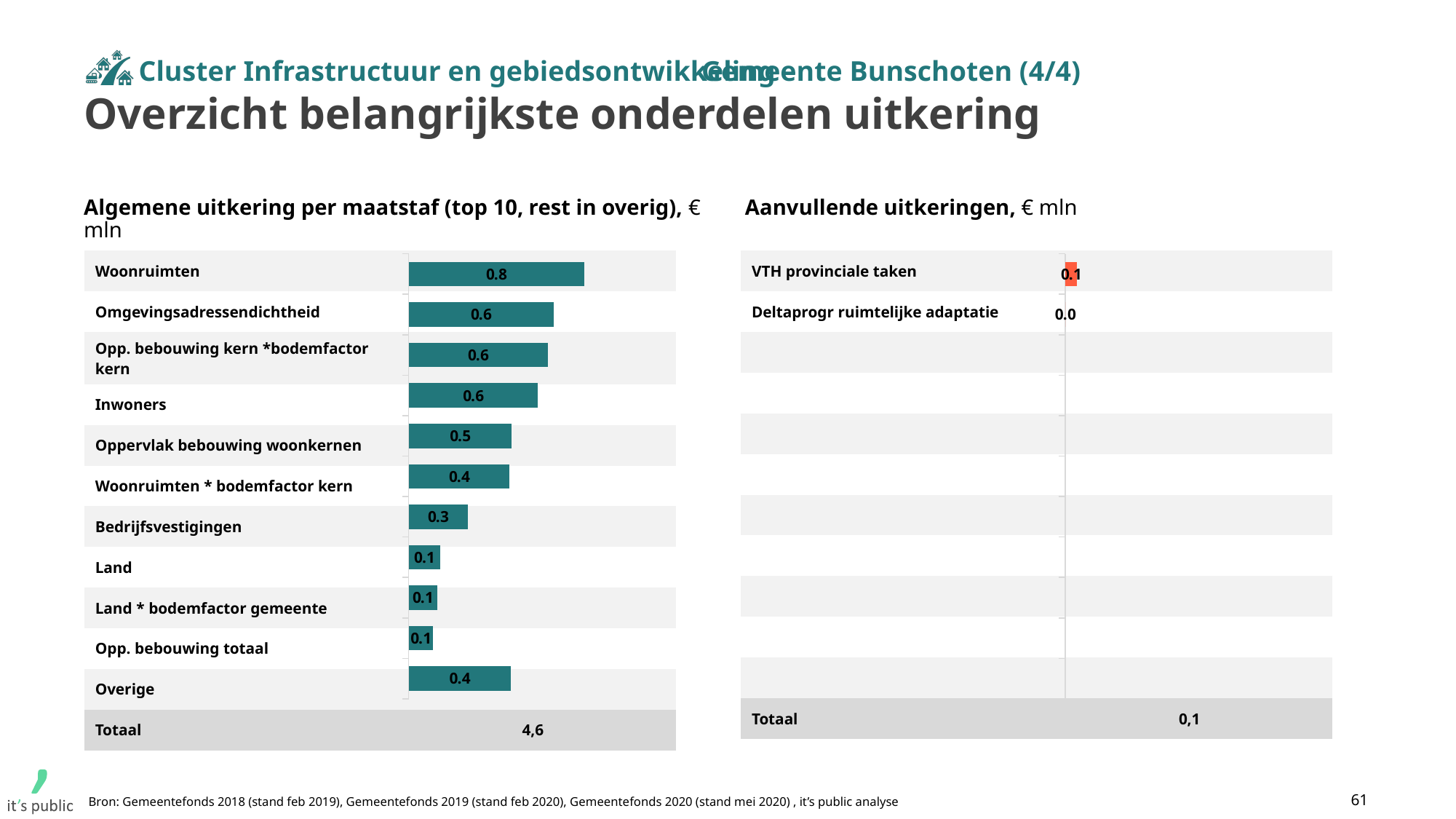
In the chart 'Algemene uitkering per maatstaf', which category has the highest value? Woonruimten What kind of chart is 'Algemene uitkering per maatstaf'? Bar chart In the chart 'Algemene uitkering per maatstaf', what is the value for Bedrijfsvestigingen? 0.3 How many categories (excluding the Totaal row) are shown in the chart 'Algemene uitkering per maatstaf'? 11 What is the Totaal shown under the chart 'Algemene uitkering per maatstaf'? 4,6 In the chart 'Algemene uitkering per maatstaf', what is the value for Overige? 0.4 In the chart 'Aanvullende uitkeringen', what is the value for VTH provinciale taken? 0.1 In the chart 'Algemene uitkering per maatstaf', what is the difference between Woonruimten and Bedrijfsvestigingen? 0.5 In the chart 'Aanvullende uitkeringen', what is the value for Deltaprogr ruimtelijke adaptatie? 0.0 What is the Totaal shown under the chart 'Aanvullende uitkeringen'? 0,1 In the chart 'Algemene uitkering per maatstaf', what is the value for Woonruimten? 0.8 In the chart 'Algemene uitkering per maatstaf', which is larger: Inwoners or Woonruimten * bodemfactor kern? Inwoners